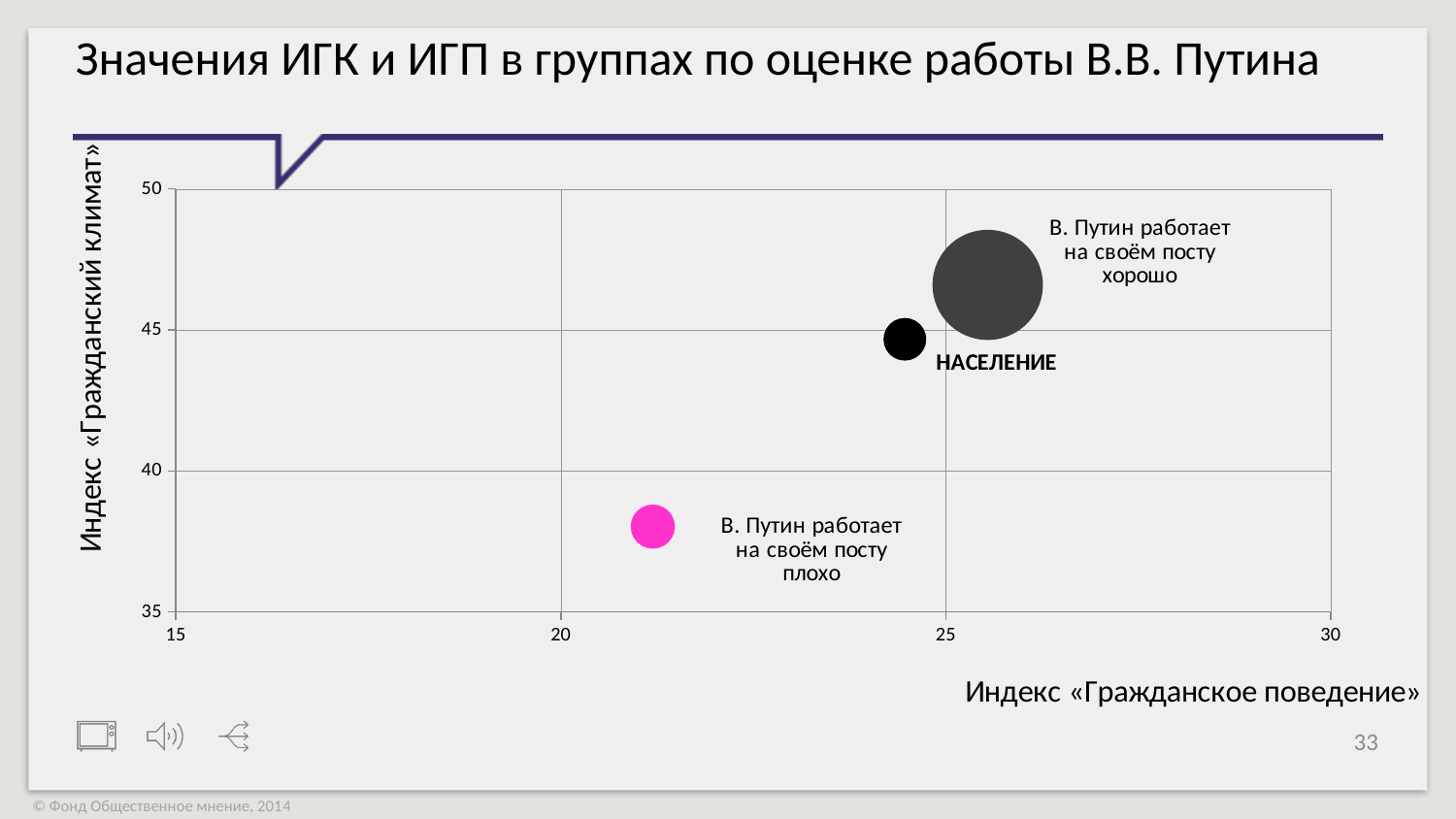
Is the horizontal-axis value for the group «В. Путин работает на своём посту плохо» greater or less than 20? greater How many bubbles (groups) are plotted on the chart? 3 Which group has the highest value on the horizontal axis (Индекс «Гражданское поведение»)? В. Путин работает на своём посту хорошо Which group is higher on the vertical axis: «В. Путин работает на своём посту хорошо» or НАСЕЛЕНИЕ? В. Путин работает на своём посту хорошо Is the vertical-axis value for the group «В. Путин работает на своём посту хорошо» greater or less than 45? greater Which group has the lowest value on the horizontal axis (Индекс «Гражданское поведение»)? В. Путин работает на своём посту плохо What kind of chart is shown on the slide? Bubble chart Which group has the lowest value on the vertical axis (Индекс «Гражданский климат»)? В. Путин работает на своём посту плохо Is the horizontal-axis value for НАСЕЛЕНИЕ greater or less than 25? less What is the title of the chart on the slide? Значения ИГК и ИГП в группах по оценке работы В.В. Путина Which group has the highest value on the vertical axis (Индекс «Гражданский климат»)? В. Путин работает на своём посту хорошо